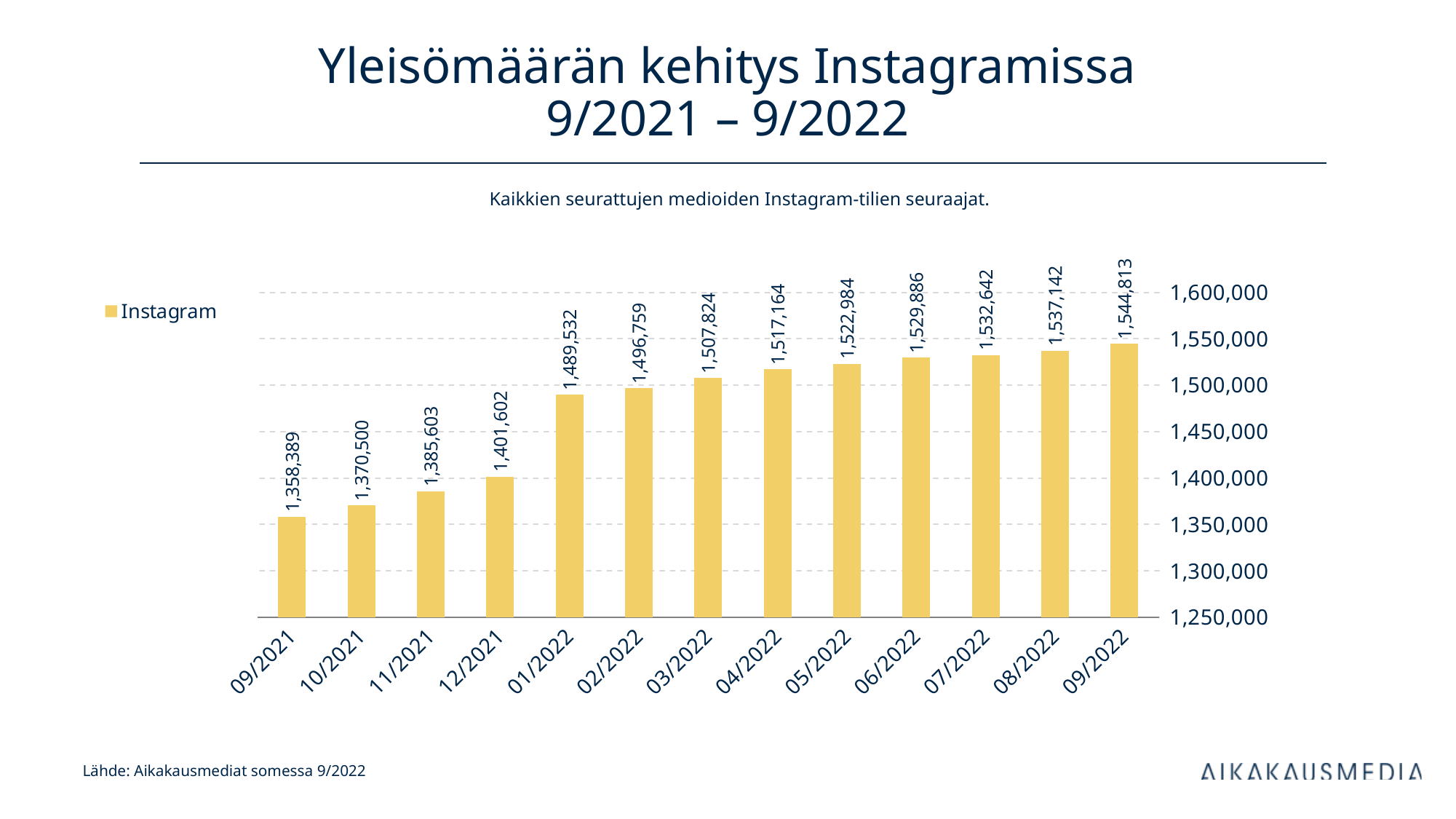
Which month has the highest value? 09/2022 What is the value for 01/2022? 1,489,532 What kind of chart is shown on the slide? bar chart What is the difference between the values for 01/2022 and 12/2021? 87,930 Do the values rise or fall from 09/2021 to 09/2022? rise What is the difference between the values for 09/2022 and 09/2021? 186,424 Which month has the lowest value? 09/2021 Is the value for 11/2021 greater or less than 1,400,000? less How many months are shown on the x axis? 13 What is the value for 09/2022? 1,544,813 Which is larger, the value for 12/2021 or the value for 01/2022? 01/2022 What is the value for 09/2021? 1,358,389